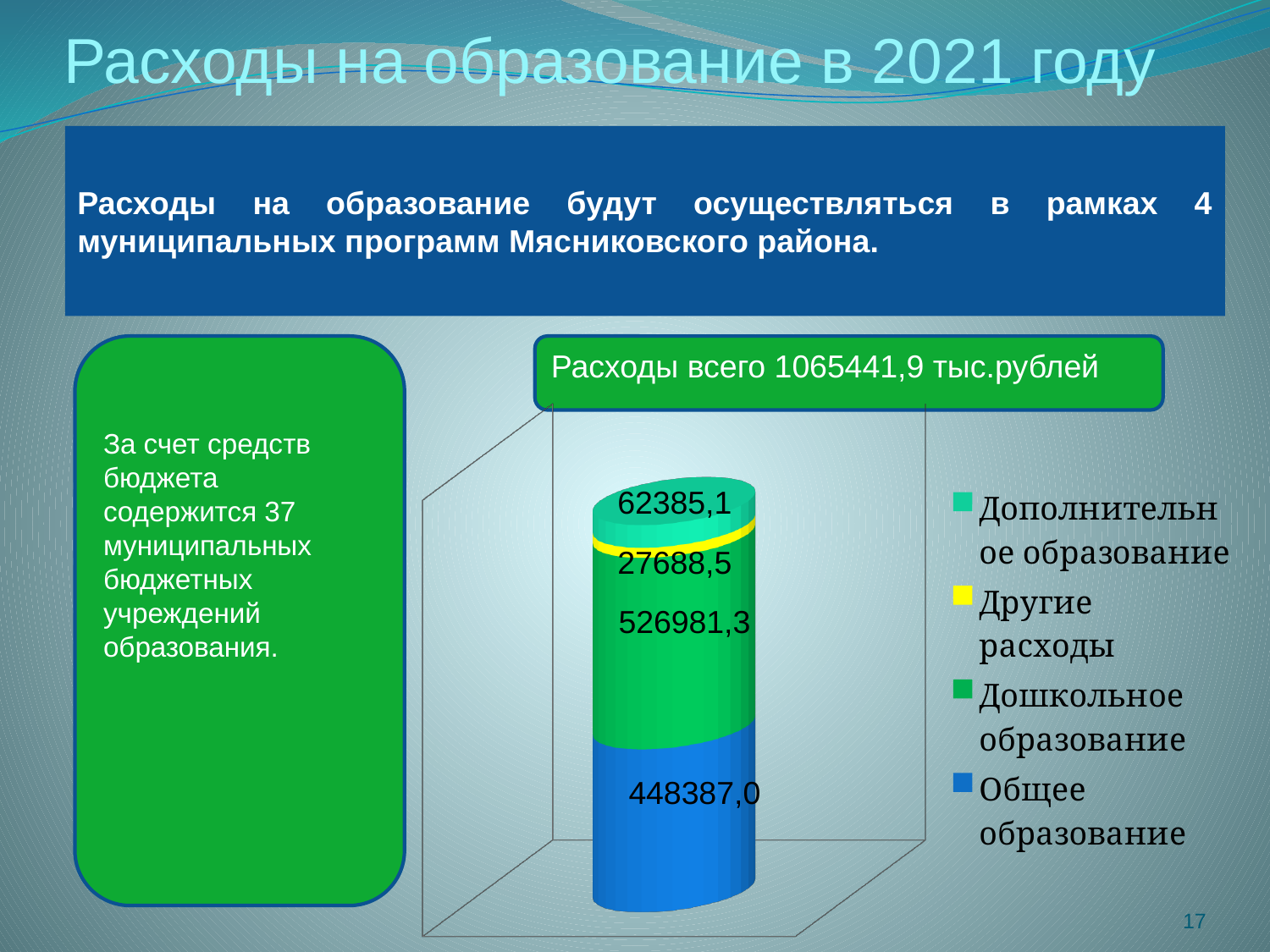
What colour is the segment for Другие расходы? Yellow What is the total of all segments in the stacked bar? 1065441,9 Which segment of the stacked bar has the smallest value? Другие расходы What is the difference between the values for Дошкольное образование and Общее образование? 78594,3 What is the value for Другие расходы in the chart? 27688,5 Which segment of the stacked bar has the largest value? Дошкольное образование What is the value for Дополнительное образование in the chart? 62385,1 What kind of chart is shown on the slide? Stacked bar chart What is the value for Общее образование in the chart? 448387,0 Which is larger: the value for Дополнительное образование or the value for Другие расходы? Дополнительное образование How many series does the legend list? 4 What is the value for Дошкольное образование in the chart? 526981,3